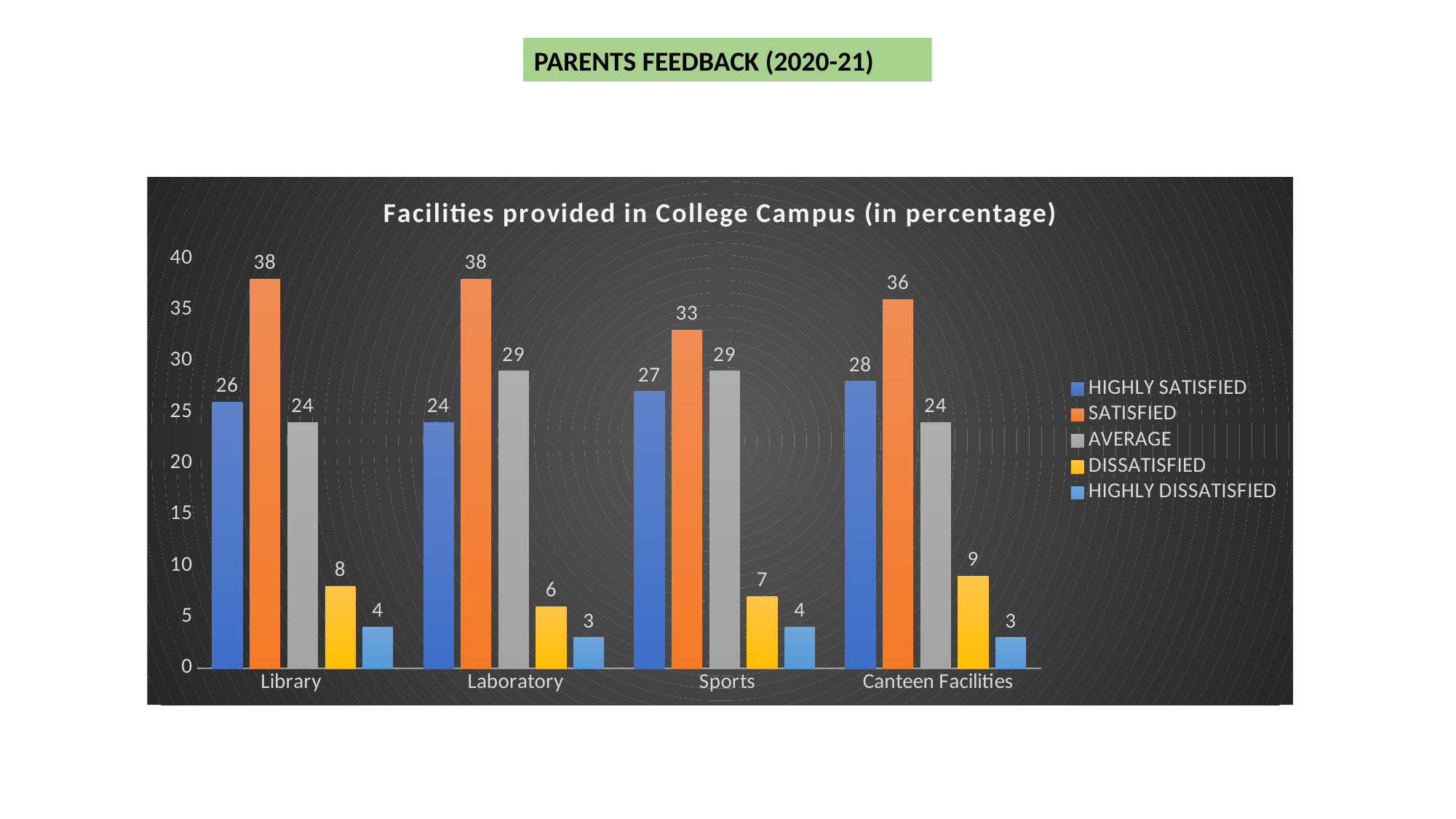
What is the DISSATISFIED value for Sports? 7 Is the SATISFIED value for Canteen Facilities greater or less than 30? greater What is the HIGHLY SATISFIED value for Canteen Facilities? 28 What is the title of the chart? Facilities provided in College Campus (in percentage) Which category has the highest AVERAGE value? Laboratory and Sports (29) What is the SATISFIED value for Library? 38 How many series does the legend list? 5 Which category has the lowest HIGHLY SATISFIED value? Laboratory Which is larger, the DISSATISFIED value for Canteen Facilities or for Library? Canteen Facilities How many categories are shown on the x axis? 4 What kind of chart is shown? bar chart What is the difference between the SATISFIED values for Library and Sports? 5